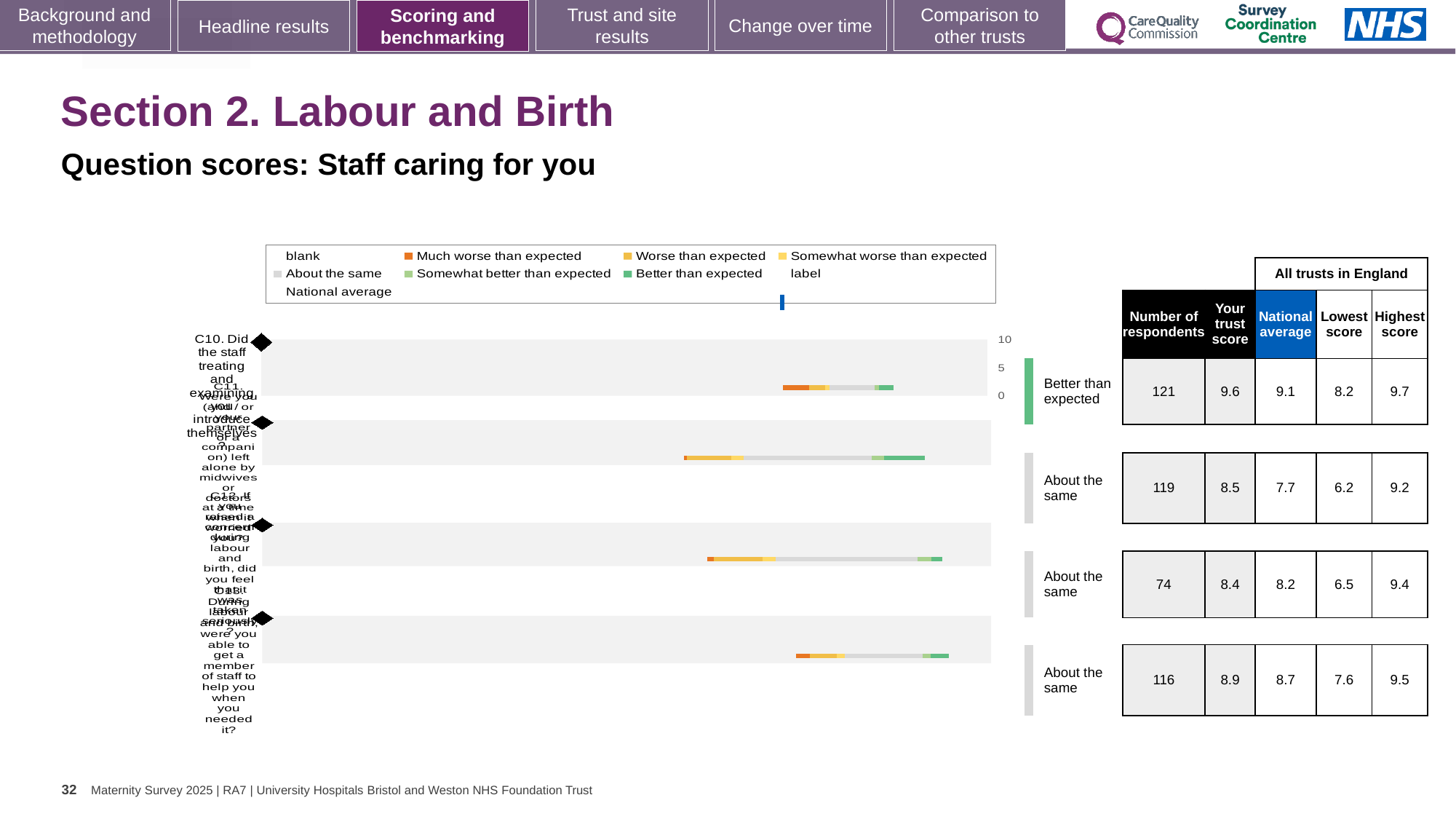
Which row has the fewest respondents in the table next to the chart? the third row, 74 In the table next to the chart, what is the highest score for the bottom row? 9.5 Which row is rated 'Better than expected' in the labels beside the chart? the top row (C10) Which row has the highest trust score in the table next to the chart? the top row (C10), 9.6 What kind of chart is shown on the slide? bar chart How many question rows (bars) are plotted in the chart? 4 In the table next to the chart, what is the national average for the second row? 7.7 In the table next to the chart, what is the trust score for the top row (C10)? 9.6 Is the trust score for the bottom row larger or smaller than its national average? larger What is the difference between the trust score and the national average for the second row in the table? 0.8 In the table next to the chart, what is the number of respondents for the top row (C10)? 121 In the table next to the chart, what is the lowest score for the third row? 6.5